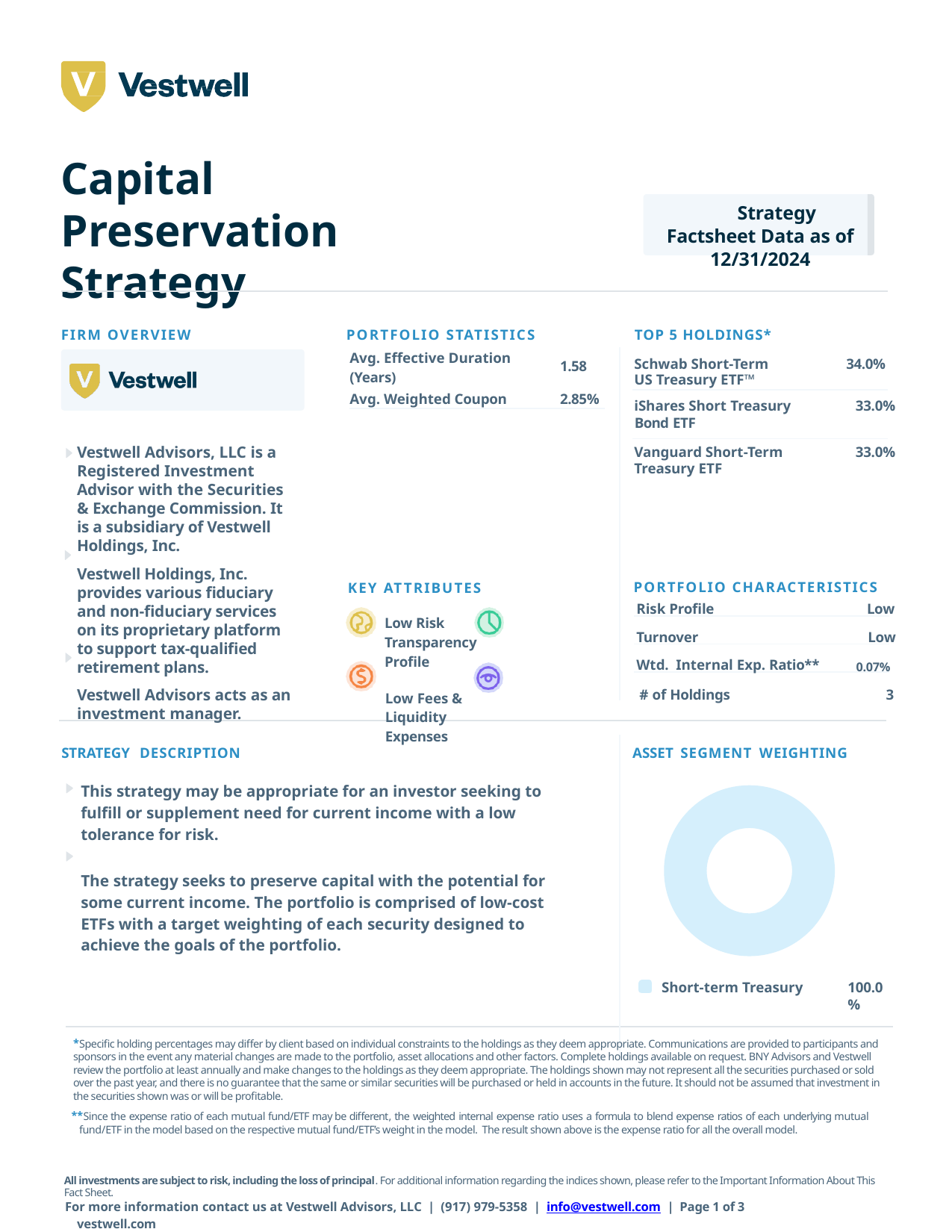
What share of the Asset Segment Weighting pie does Short-term Treasury represent? 100.0% What is the title of the chart on the slide? Asset Segment Weighting What kind of chart is shown under Asset Segment Weighting? donut (pie) chart What is the name of the only legend entry in the Asset Segment Weighting chart? Short-term Treasury Which asset segment is the largest in the Asset Segment Weighting chart? Short-term Treasury How many entries does the legend of the Asset Segment Weighting chart list? 1 In the Asset Segment Weighting chart, what is the weighting for Short-term Treasury? 100.0% How many segments does the Asset Segment Weighting chart contain? 1